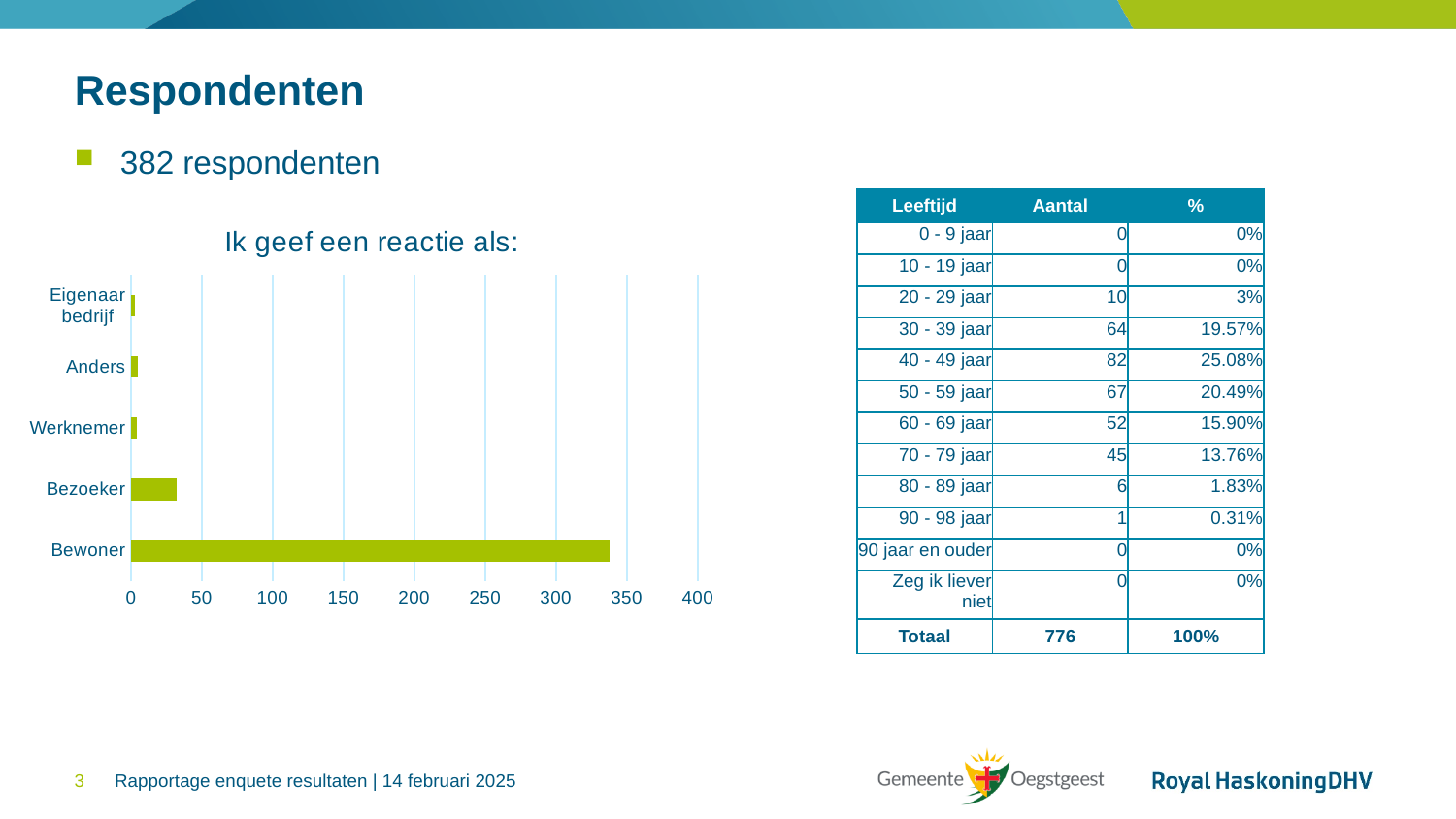
Which category has the highest value in the chart? Bewoner Which is larger, the value for Bewoner or the value for Bezoeker? Bewoner Is the value for Bewoner greater or less than 350? less Which is larger, the value for Bezoeker or the value for Werknemer? Bezoeker Is the value for Bezoeker greater or less than 50? less How many categories does the chart show? 5 Is the value for Bewoner greater or less than 300? greater What is the title of the chart? Ik geef een reactie als: What is the highest value shown on the chart's horizontal axis? 400 What kind of chart is shown on the slide? bar chart